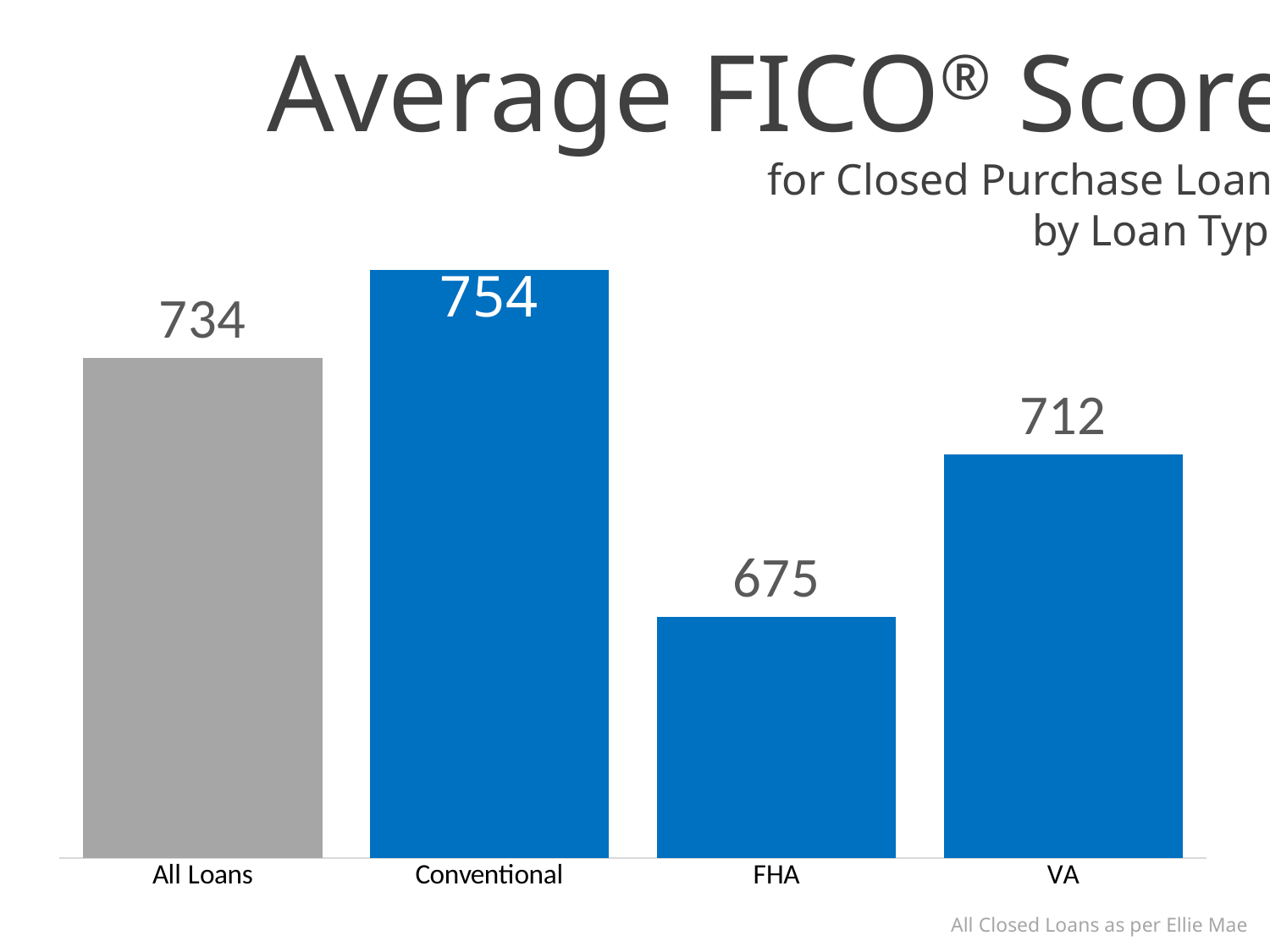
Which loan type has the lowest average FICO score? FHA What is the difference between the average FICO score for Conventional loans and FHA loans? 79 What is the average FICO score for VA loans? 712 What is the average FICO score for All Loans? 734 Which bar is coloured grey rather than blue? All Loans Which has a higher average FICO score, VA or FHA? VA What is the difference between the average FICO score for All Loans and VA loans? 22 What is the average FICO score for FHA loans? 675 What is the average FICO score for Conventional loans? 754 What kind of chart is shown on the slide? Bar chart Which loan type has the highest average FICO score? Conventional How many loan categories are shown in the chart? 4